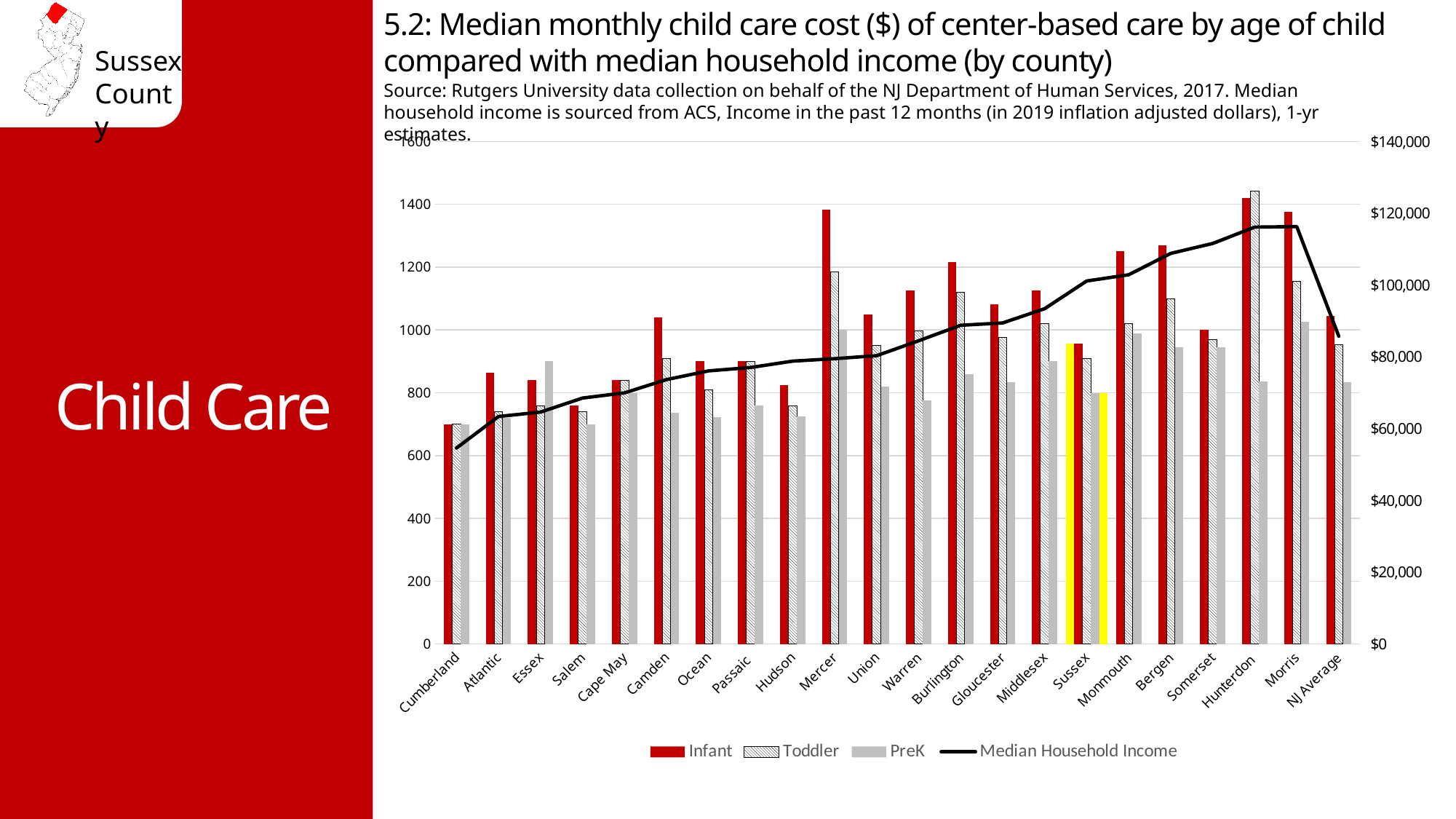
Which is larger for Essex, the Infant cost or the PreK cost? PreK What kind of chart is shown on the slide? Bar chart with a line Does the Median Household Income line generally rise or fall from Cumberland to Morris? rise Which county's bars are highlighted in yellow? Sussex How many series does the legend list? 4 Which category has the highest Toddler cost? Hunterdon Is the Median Household Income for Morris greater or less than $100,000? greater Is the Median Household Income for Cumberland greater or less than $60,000? less How many counties/categories are shown along the x axis? 22 Is the Infant cost for Sussex greater or less than 1000? less Which category has the lowest Infant cost? Cumberland